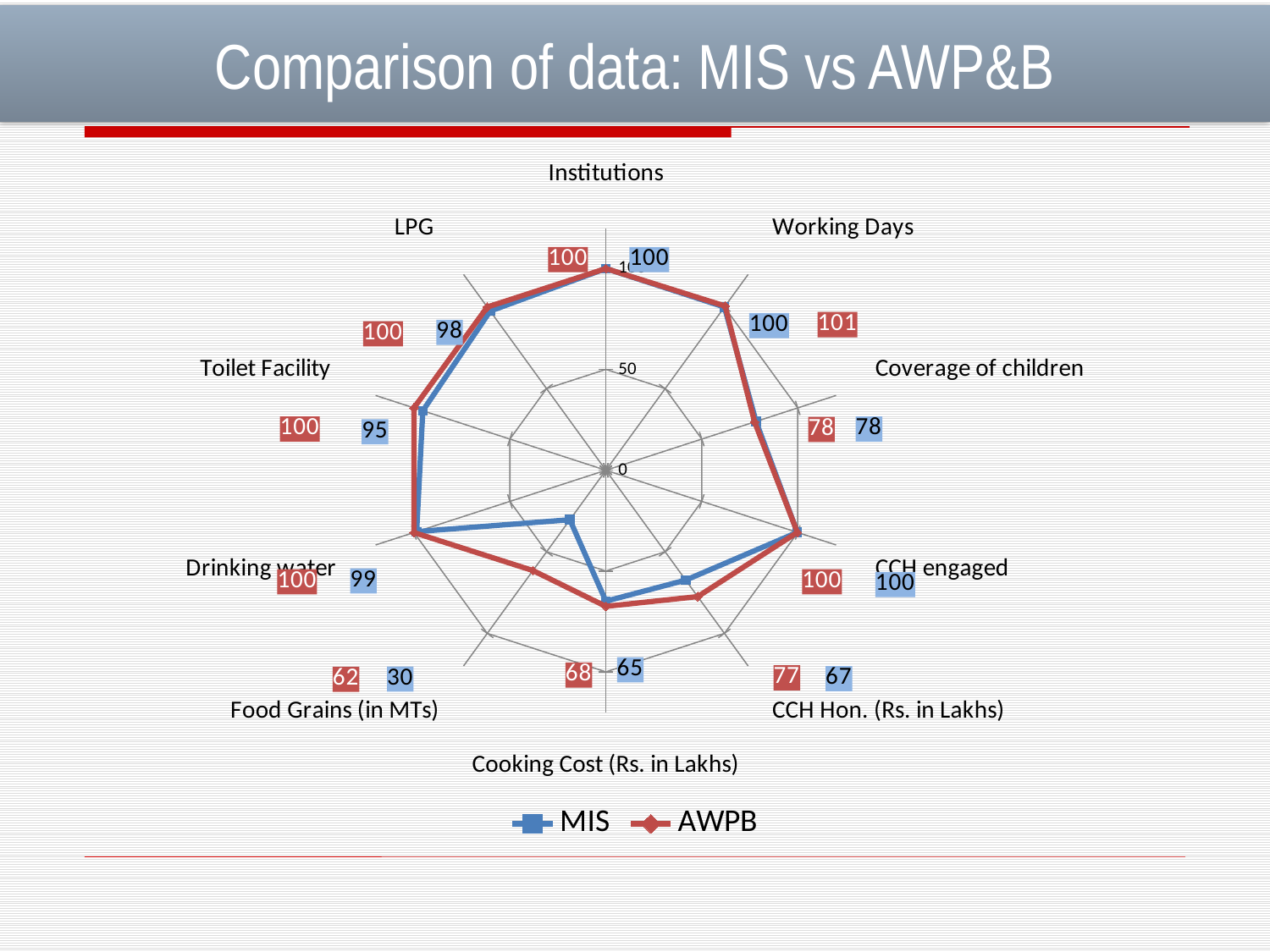
How many series does the legend list? 2 Which category has the lowest MIS value? Food Grains (in MTs) What is the AWPB value for Working Days? 101 What is the difference between the AWPB and MIS values for CCH Hon. (Rs. in Lakhs)? 10 What kind of chart is shown on the slide? Radar chart How many categories are plotted on the chart? 10 What is the MIS value for Food Grains (in MTs)? 30 What is the MIS value for CCH Hon. (Rs. in Lakhs)? 67 Which series has the larger value for Cooking Cost (Rs. in Lakhs), MIS or AWPB? AWPB What is the AWPB value for Food Grains (in MTs)? 62 What is the difference between the AWPB and MIS values for Food Grains (in MTs)? 32 What is the MIS value for Toilet Facility? 95